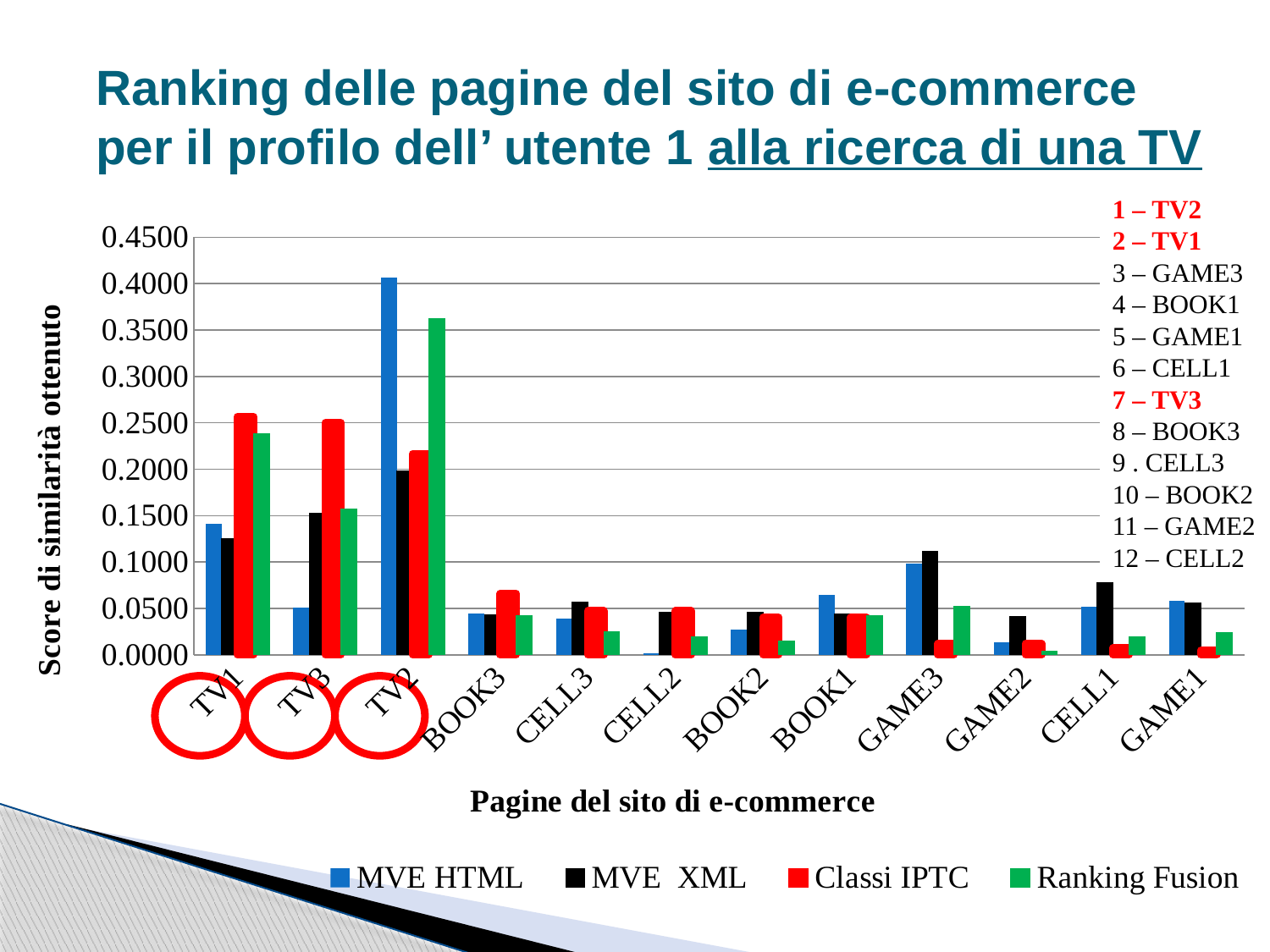
For TV2, which series has the highest bar? MVE HTML Is the Ranking Fusion value for TV2 greater or less than 0.3000? greater How many categories (pages) are shown on the x axis of the chart? 12 Which category has the highest MVE HTML bar? TV2 What colour are the Ranking Fusion bars in the chart? green What is the title of the y axis of the chart? Score di similarità ottenuto Is the MVE HTML value for TV3 greater or less than 0.1000? less Is the MVE HTML value for TV2 greater or less than 0.3500? greater How many series does the chart legend list? 4 For TV1, which series has the highest bar? Classi IPTC What kind of chart is shown on the slide? bar chart Which is larger for TV1: the MVE HTML value or the Classi IPTC value? Classi IPTC